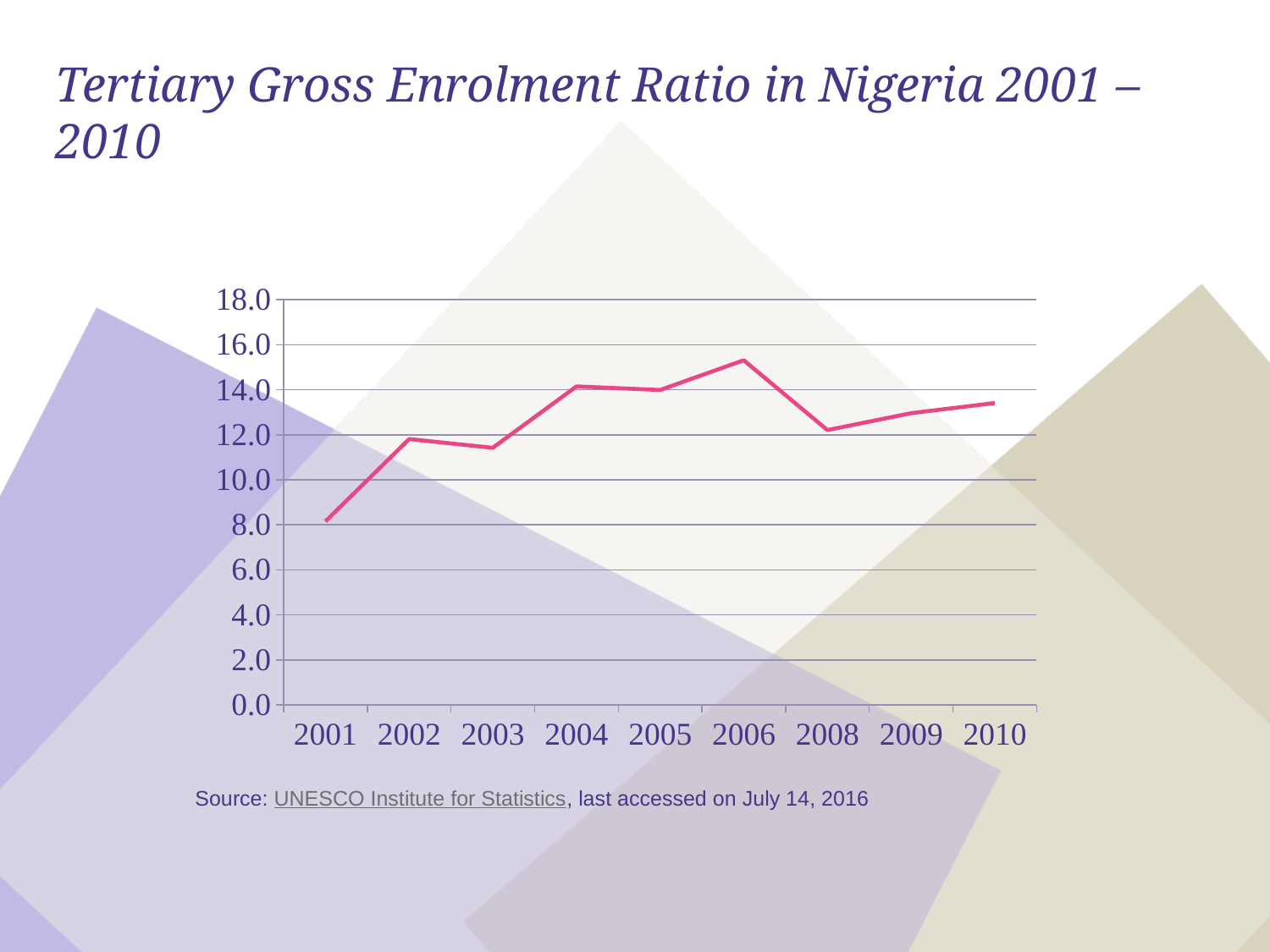
Which year has the highest tertiary gross enrolment ratio? 2006 Overall, does the tertiary gross enrolment ratio rise or fall from 2001 to 2010? rise How many years are plotted on the x axis of the chart? 9 Is the value for 2001 greater or less than 10.0? less What is the title of the chart on the slide? Tertiary Gross Enrolment Ratio in Nigeria 2001 – 2010 What kind of chart is shown on the slide? line chart Is the value for 2004 greater or less than 12.0? greater Is the value for 2006 greater or less than 14.0? greater Which year has the lowest tertiary gross enrolment ratio? 2001 Which year has the larger value, 2006 or 2008? 2006 Which year has the larger value, 2001 or 2002? 2002